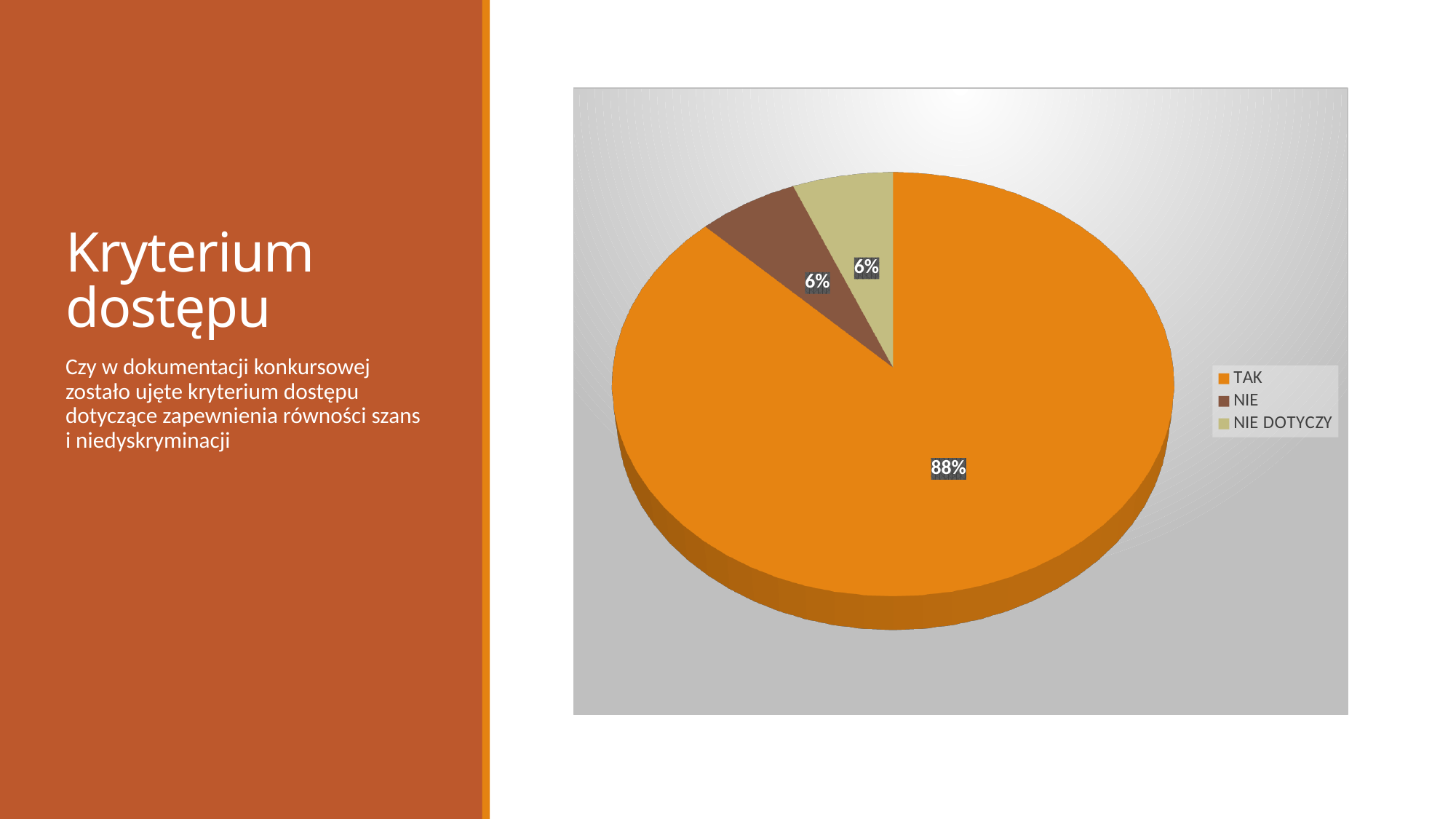
What is the combined share of NIE and NIE DOTYCZY? 12% What share of the pie does NIE have? 6% What kind of chart is shown on the slide? pie chart Which legend entry is shown in brown? NIE Which is larger, the TAK slice or the NIE DOTYCZY slice? TAK How many entries does the legend list? 3 Which category has the largest slice of the pie? TAK How many categories does the pie chart show? 3 What is the difference between the TAK share and the NIE share? 82% What share of the pie does TAK have? 88% Which legend entry is shown in orange? TAK What share of the pie does NIE DOTYCZY have? 6%